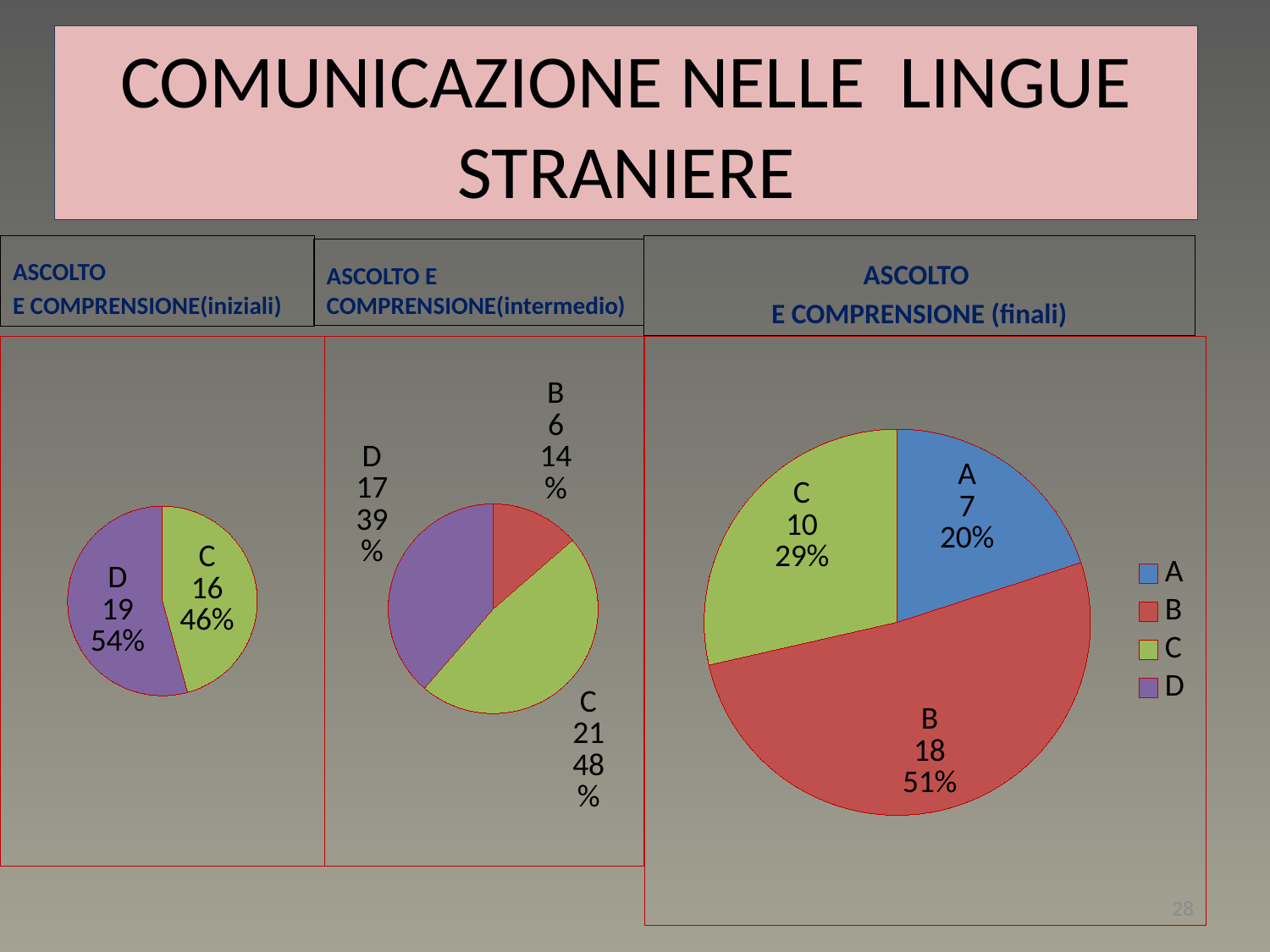
In the 'ASCOLTO E COMPRENSIONE (finali)' chart, what is the difference between the values for B and C? 8 In the 'ASCOLTO E COMPRENSIONE (finali)' chart, what share of the pie does A have? 20% In the 'ASCOLTO E COMPRENSIONE (finali)' chart, what is the value for B? 18 In the 'ASCOLTO E COMPRENSIONE(intermedio)' chart, which category has the lowest value? B In the 'ASCOLTO E COMPRENSIONE(intermedio)' chart, what is the value for C? 21 In the 'ASCOLTO E COMPRENSIONE(intermedio)' chart, what share of the pie does D have? 39% In the 'ASCOLTO E COMPRENSIONE (finali)' chart, how many slices does the pie have? 3 How many entries does the legend of the 'ASCOLTO E COMPRENSIONE (finali)' chart list? 4 What kind of chart is used for 'ASCOLTO E COMPRENSIONE(iniziali)'? pie chart In the 'ASCOLTO E COMPRENSIONE (finali)' chart, which category has the highest value? B In the 'ASCOLTO E COMPRENSIONE(iniziali)' chart, what is the value for D? 19 In the 'ASCOLTO E COMPRENSIONE(iniziali)' chart, what share of the pie does C have? 46%